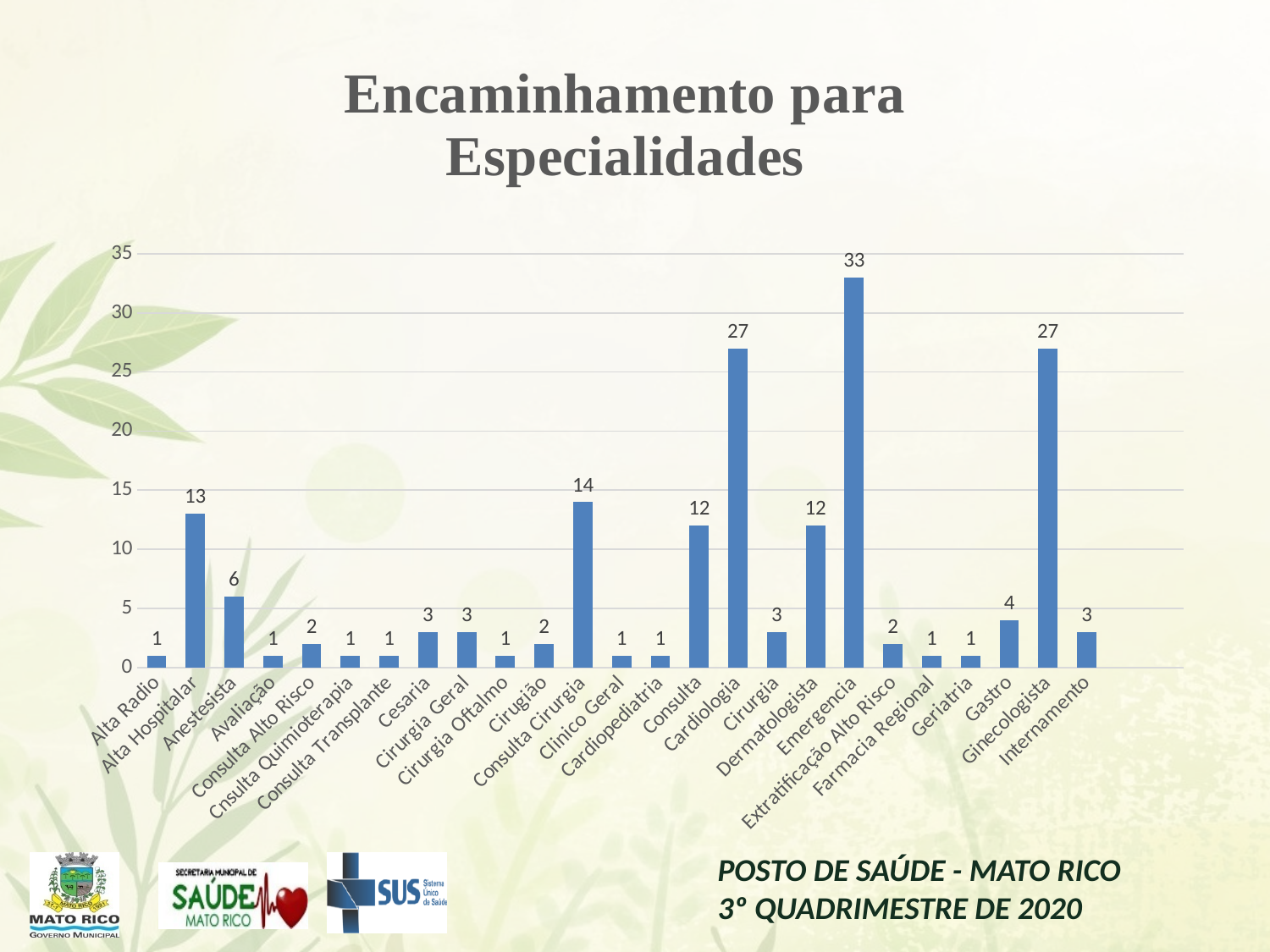
What is the difference between the values for Emergencia and Cardiologia? 6 Which is larger, the value for Dermatologista or the value for Consulta Cirurgia? Consulta Cirurgia What is the value for Emergencia? 33 What is the value for Alta Hospitalar? 13 What is the value for Consulta Cirurgia? 14 How many categories are shown on the x axis? 25 What is the title of the chart? Encaminhamento para Especialidades Which is larger, the value for Consulta or the value for Gastro? Consulta What is the difference between the values for Alta Hospitalar and Anestesista? 7 What kind of chart is shown on the slide? Bar chart What is the value for Ginecologista? 27 Which category has the highest value? Emergencia